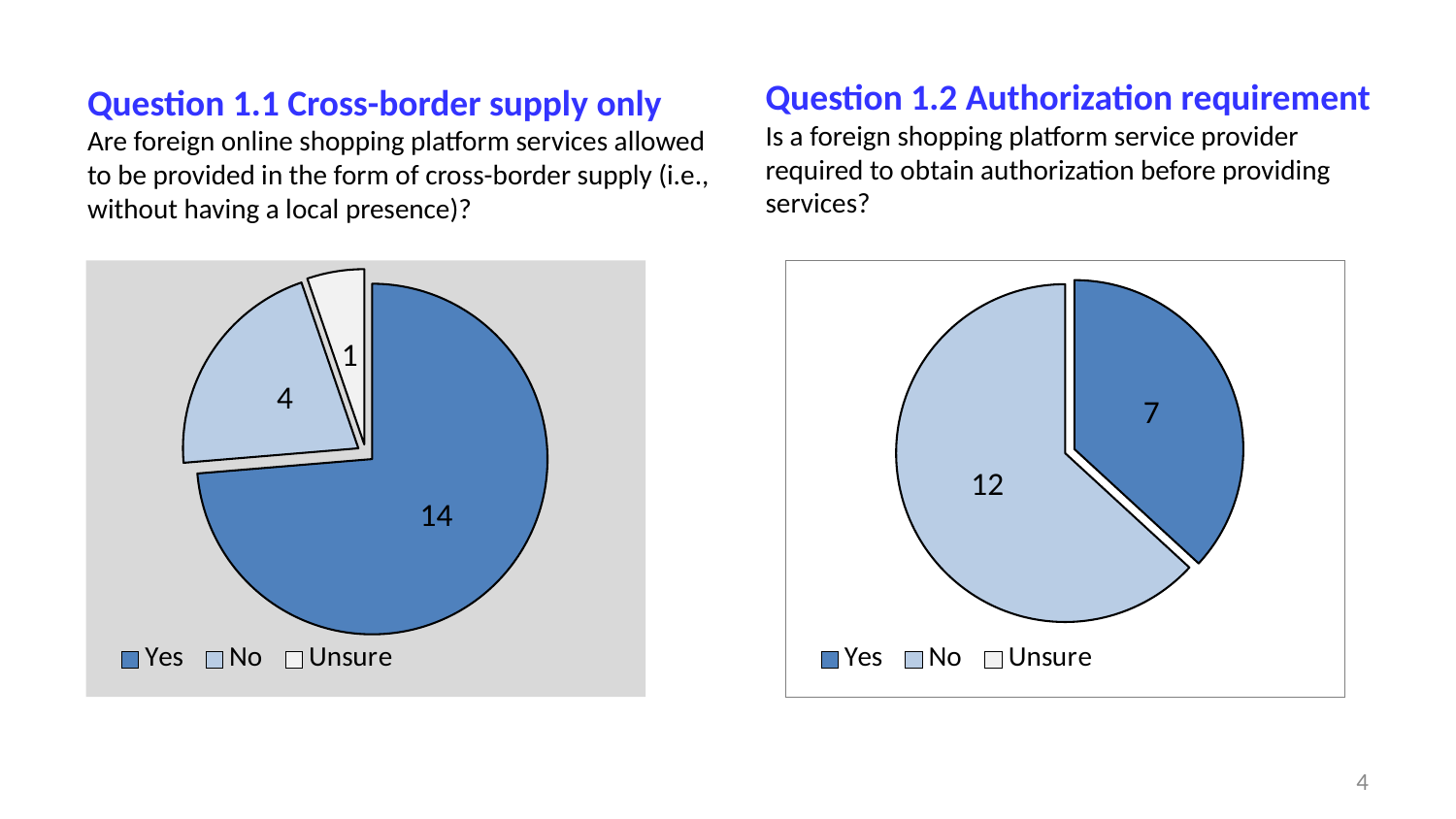
In the Question 1.2 Authorization requirement chart, what is the value for No? 12 In the Question 1.2 Authorization requirement chart, what is the value for Yes? 7 In the Question 1.1 Cross-border supply only chart, what is the value for No? 4 What type of chart is used for Question 1.2 Authorization requirement? Pie chart In the Question 1.1 Cross-border supply only chart, what is the value for Yes? 14 In the Question 1.2 Authorization requirement chart, what is the difference between the No and Yes values? 5 How many entries does the legend of the Question 1.2 Authorization requirement chart list? 3 In the Question 1.1 Cross-border supply only chart, what is the difference between the Yes and No values? 10 In the Question 1.1 Cross-border supply only chart, which category has the largest slice? Yes In the Question 1.1 Cross-border supply only chart, what is the value for Unsure? 1 In the Question 1.2 Authorization requirement chart, which category has the largest slice? No In the Question 1.1 Cross-border supply only chart, which category has the smallest slice? Unsure